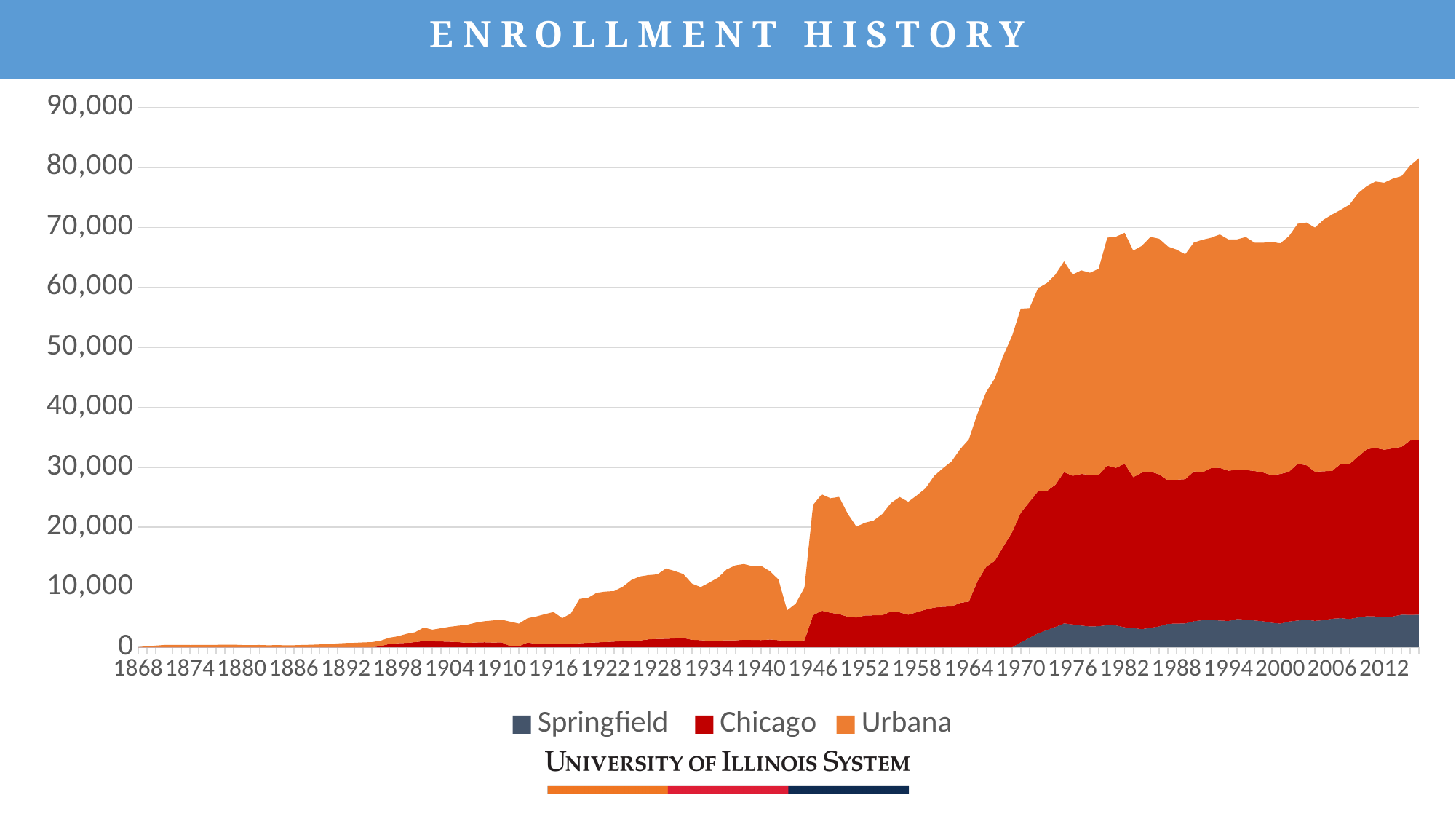
Which campus has the largest enrollment at the right end of the chart (2012)? Urbana What is the title of the chart? ENROLLMENT HISTORY What is the first year labeled on the x axis? 1868 Is the total enrollment in 1970 greater or less than 50,000? greater How many series does the legend list? 3 Is the total enrollment in 2012 greater or less than 70,000? greater Is the Springfield enrollment in 2012 greater or less than 10,000? less What kind of chart is shown on the slide? Stacked area chart Which campus has the smallest enrollment at the right end of the chart (2012)? Springfield Does total enrollment rise or fall overall from 1868 to 2012? Rise Which series is shown in orange in the legend? Urbana